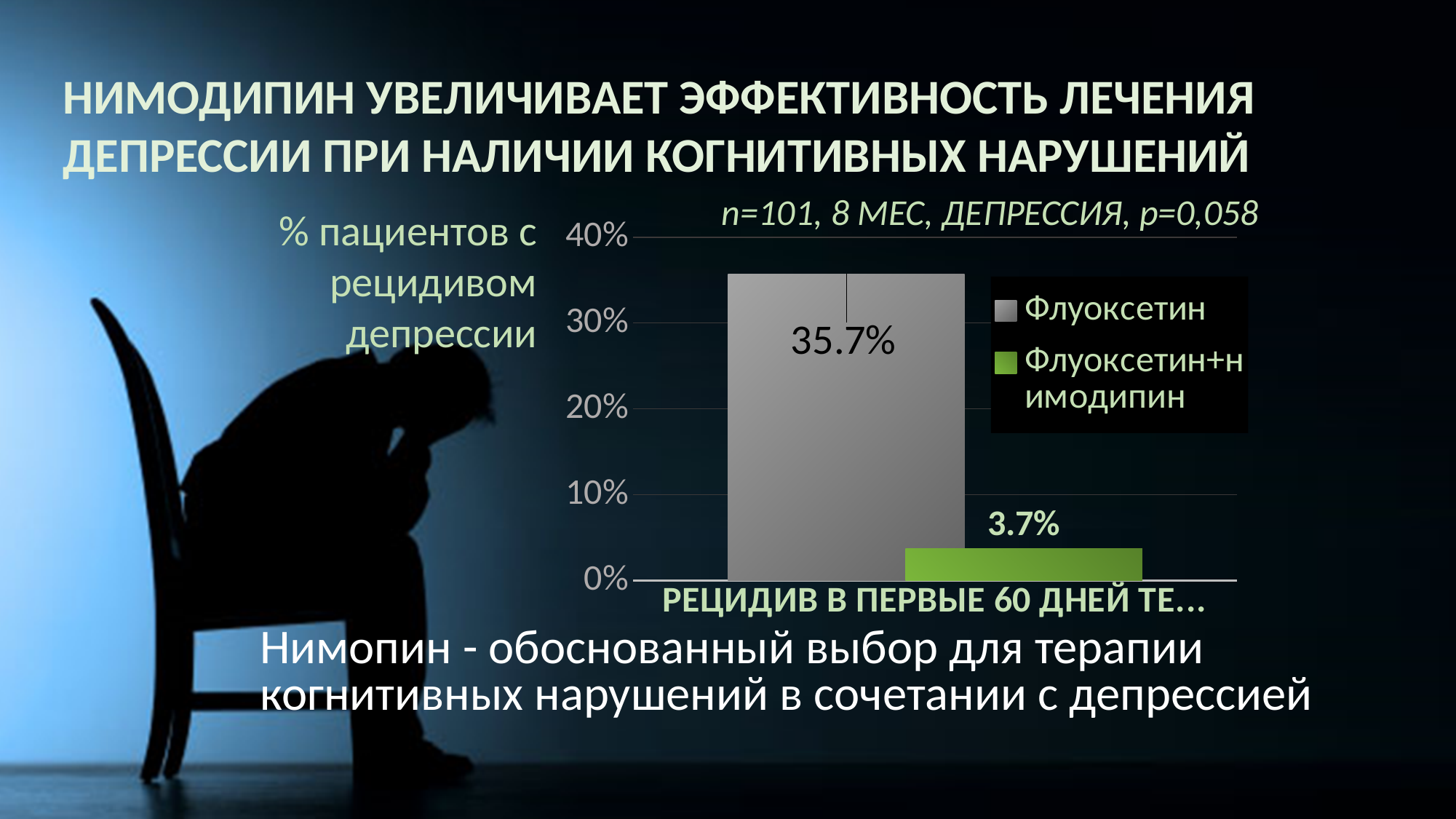
Is the value for Флуоксетин greater or less than 30%? greater Is the value for Флуоксетин+нимодипин greater or less than 10%? less What is the value for Флуоксетин+нимодипин in the chart? 3.7% What kind of chart is shown on the slide? Bar chart What is the value for Флуоксетин in the chart? 35.7% What is the difference between the Флуоксетин value and the Флуоксетин+нимодипин value? 32.0% What is the maximum value shown on the vertical axis of the chart? 40% What is the sample size (n) stated above the chart? n=101 How many series does the legend list? 2 Which series has the higher value, Флуоксетин or Флуоксетин+нимодипин? Флуоксетин Which series has the lowest value in the chart? Флуоксетин+нимодипин What colour is the bar for Флуоксетин+нимодипин? Green